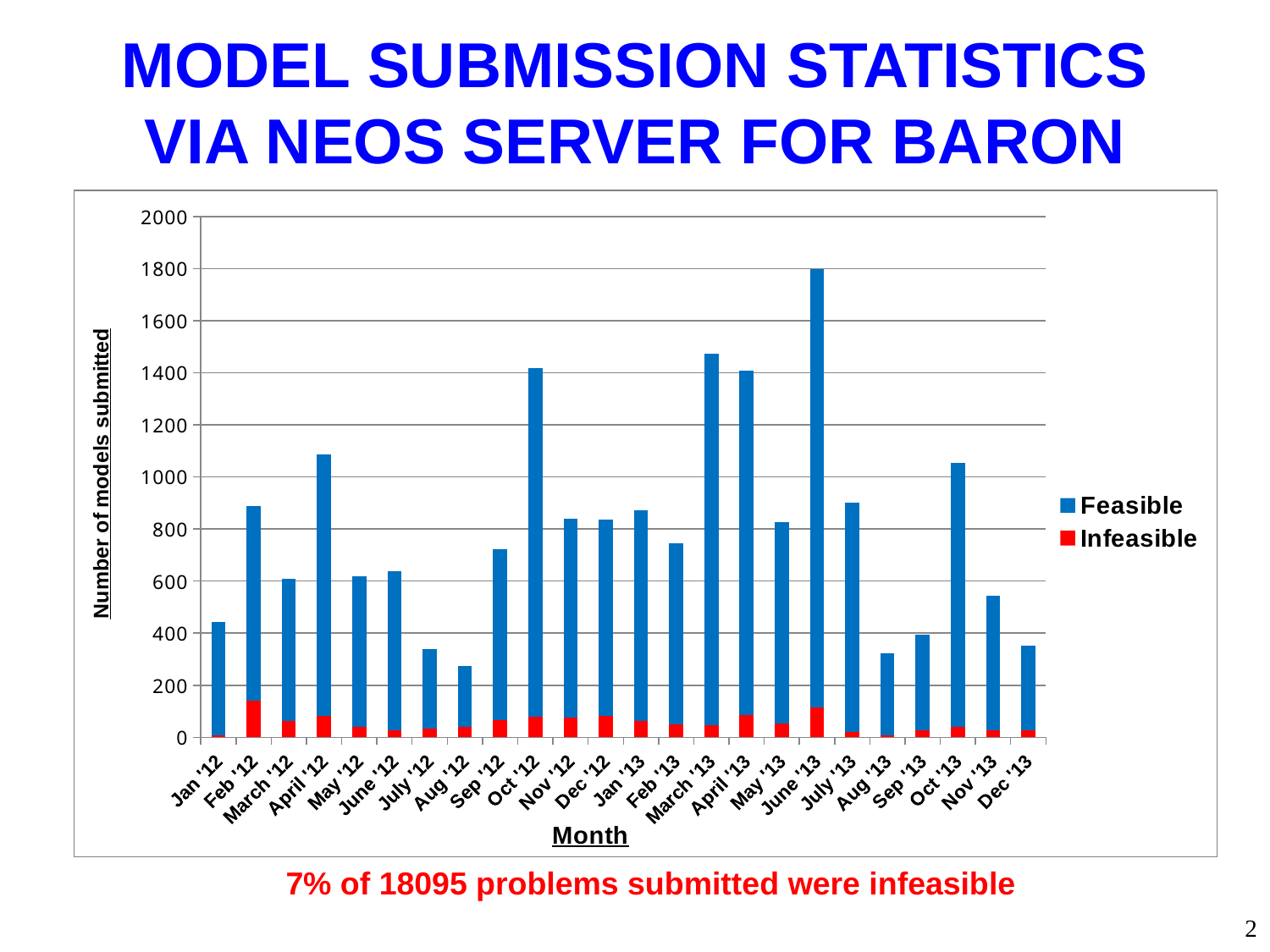
Which month has a larger total of models submitted, Oct '12 or June '13? June '13 Which month has the highest total number of models submitted? June '13 Do the total bars rise or fall from Oct '13 to Dec '13? fall Is the total number of models submitted in April '12 greater or less than 1000? greater How many series does the legend list? 2 How many months are shown along the x axis? 24 Is the total number of models submitted in June '13 greater or less than 1600? greater Which month has the lowest total number of models submitted? Aug '12 Which colour represents the Infeasible series in the legend? Red Is the total number of models submitted in Aug '12 greater or less than 400? less What kind of chart is shown on the slide? Stacked bar chart